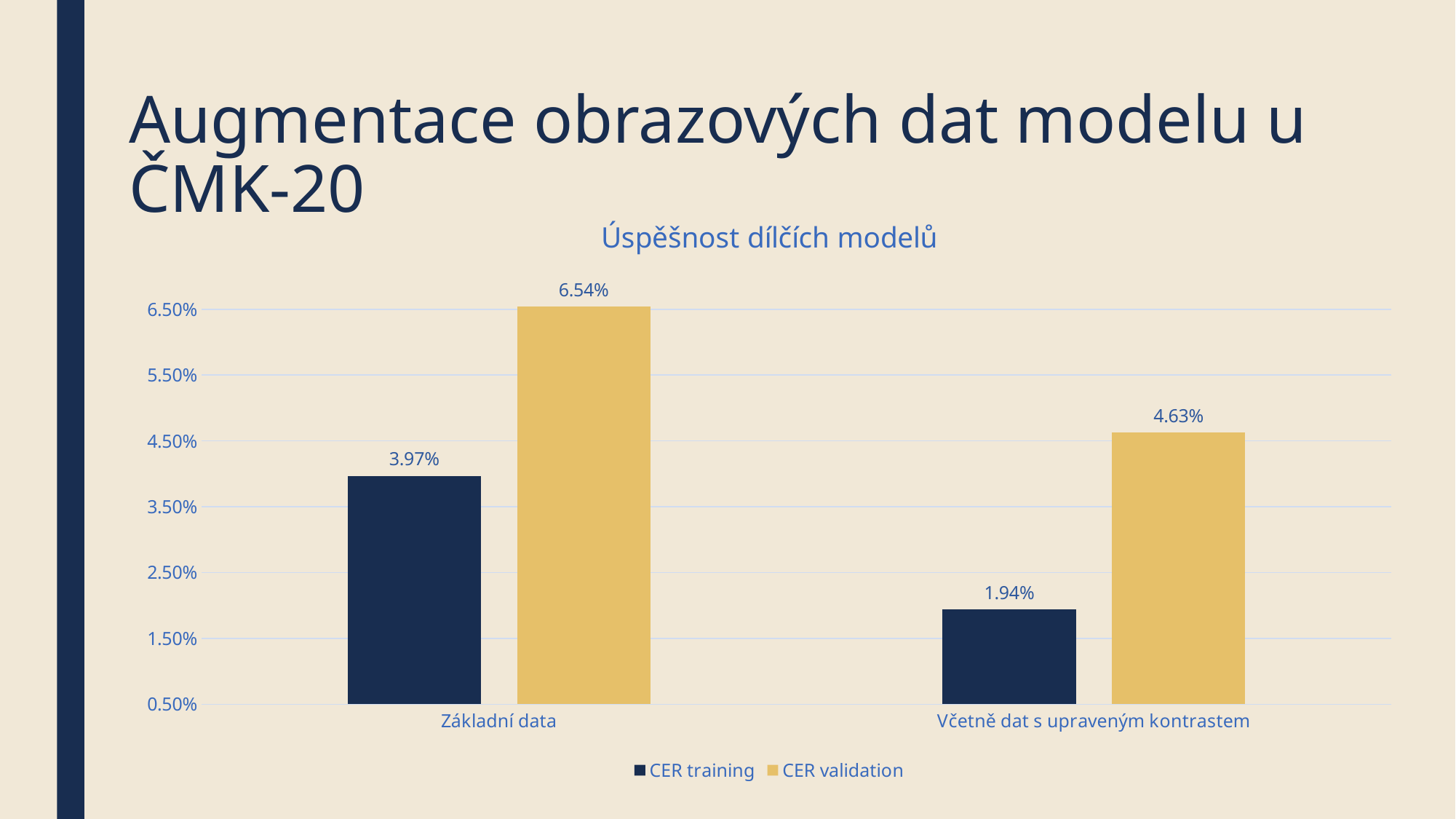
What is the CER validation value for Včetně dat s upraveným kontrastem? 4.63% How many categories are shown on the x axis? 2 What kind of chart is shown on the slide? Bar chart What is the CER training value for Základní data? 3.97% What is the CER training value for Včetně dat s upraveným kontrastem? 1.94% What is the CER validation value for Základní data? 6.54% Which bar has the highest value in the chart? CER validation for Základní data How many series does the legend list? 2 Which bar has the lowest value in the chart? CER training for Včetně dat s upraveným kontrastem Which is larger: CER training for Základní data or CER validation for Včetně dat s upraveným kontrastem? CER validation for Včetně dat s upraveným kontrastem What is the difference between the CER validation and CER training values for Základní data? 2.57% What is the title of the chart? Úspěšnost dílčích modelů